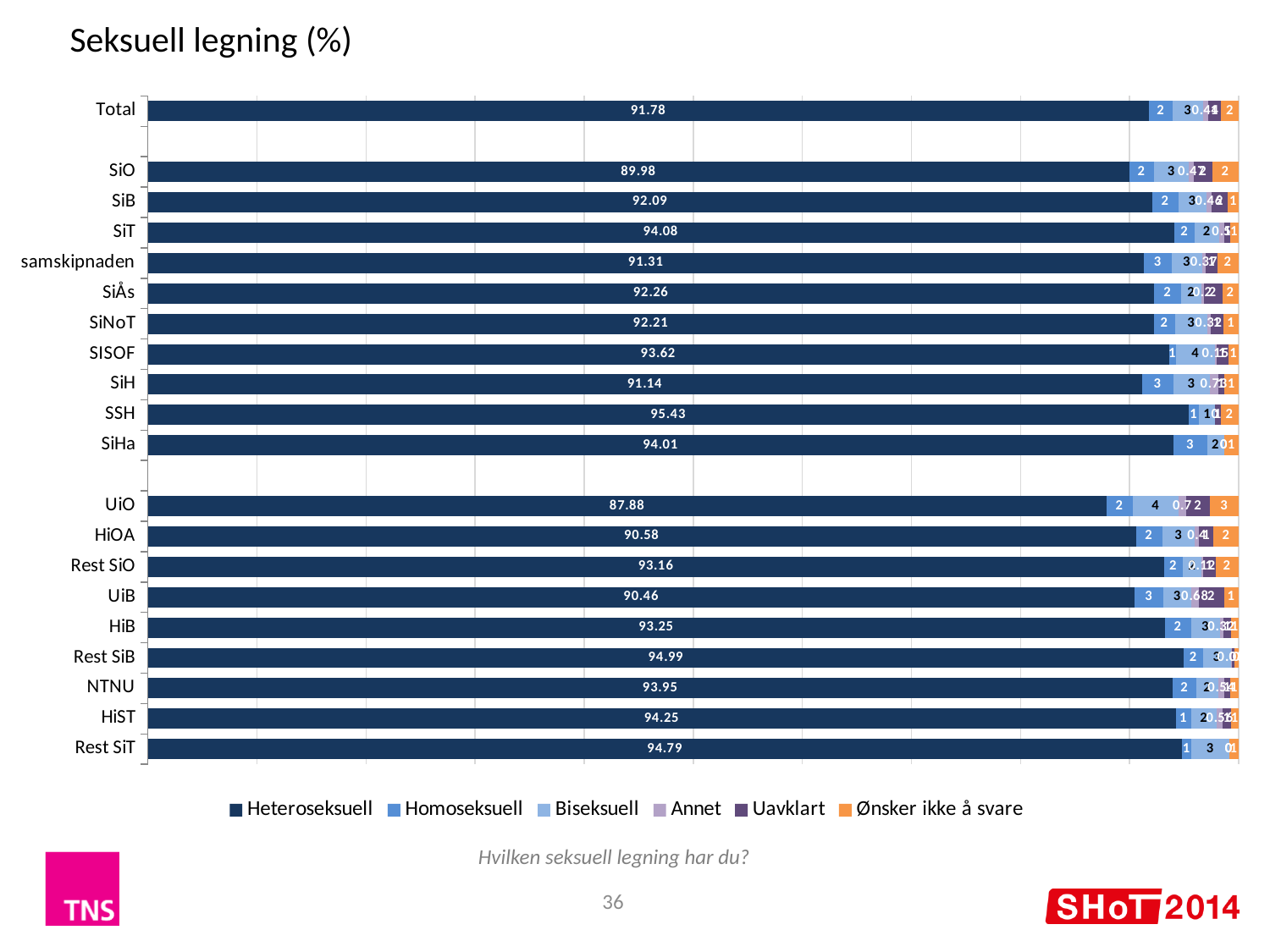
What is the Heteroseksuell value for SSH? 95.43 How many categories are shown on the y axis? 20 Which has a larger Heteroseksuell value, UiB or HiB? HiB How many series does the legend list? 6 What is the Heteroseksuell value for Total? 91.78 What kind of chart is shown on the slide? Stacked bar chart What is the difference between the Heteroseksuell values for SSH and UiO? 7.55 What is the title of the chart? Seksuell legning (%) What is the Heteroseksuell value for HiOA? 90.58 Which category has the lowest Heteroseksuell value? UiO What is the Heteroseksuell value for UiO? 87.88 Which category has the highest Heteroseksuell value? SSH